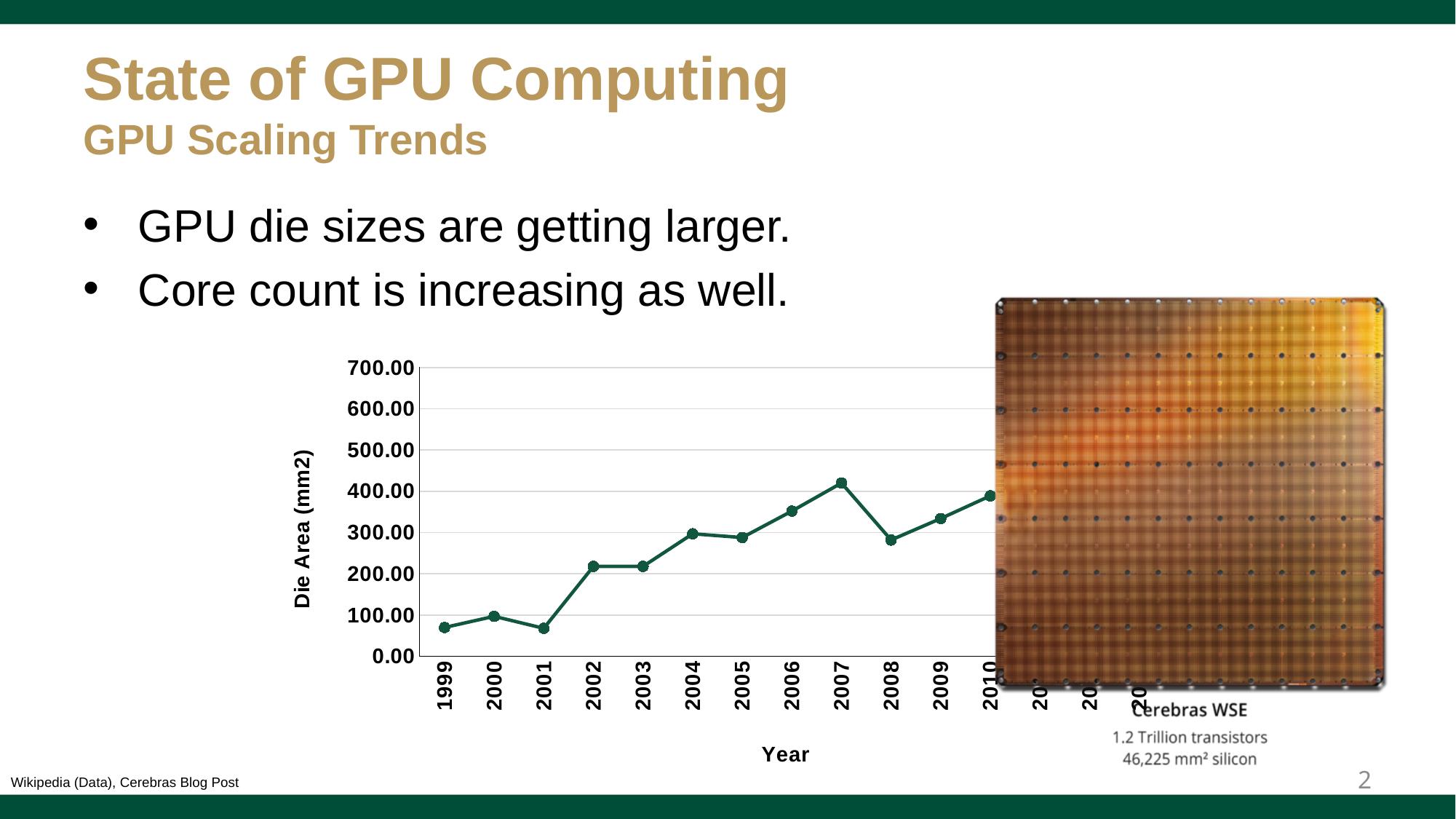
What kind of chart is shown on the slide? line chart What is the label of the vertical axis of the chart? Die Area (mm2) Is the die area for 2001 greater or less than 200.00? less Overall, does the die area rise or fall from 1999 to 2010? rise Is the die area for 1999 greater or less than 100.00? less Among the years 1999 to 2010, which year has the highest die area? 2007 Is the die area for 2007 greater or less than 300.00? greater Which year has a larger die area, 2000 or 2002? 2002 Which year has a larger die area, 2007 or 2008? 2007 What is the label of the horizontal axis of the chart? Year